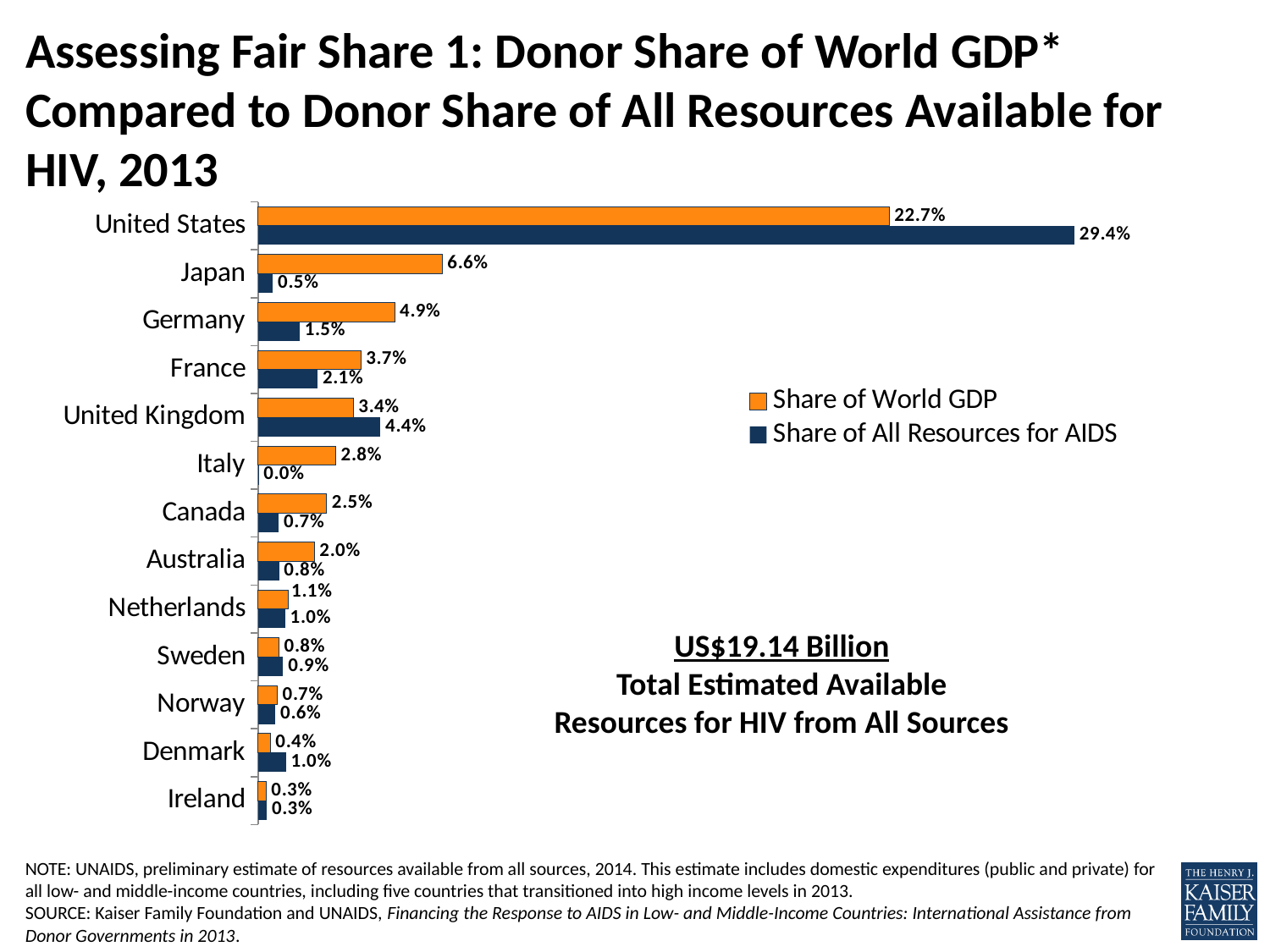
What is the Share of All Resources for AIDS for Italy? 0.0% Which country has the highest Share of All Resources for AIDS? United States Which is larger for Germany: Share of World GDP or Share of All Resources for AIDS? Share of World GDP What is the difference between the United States' Share of All Resources for AIDS and its Share of World GDP? 6.7% Which country has the lowest Share of World GDP? Ireland What kind of chart is shown on the slide? Bar chart What is the difference between Japan's Share of World GDP and its Share of All Resources for AIDS? 6.1% What is the Share of World GDP for the United States? 22.7% Which is larger for Denmark: Share of World GDP or Share of All Resources for AIDS? Share of All Resources for AIDS What is the Share of All Resources for AIDS for the United Kingdom? 4.4% How many series does the legend list? 2 How many countries are shown in the chart? 13